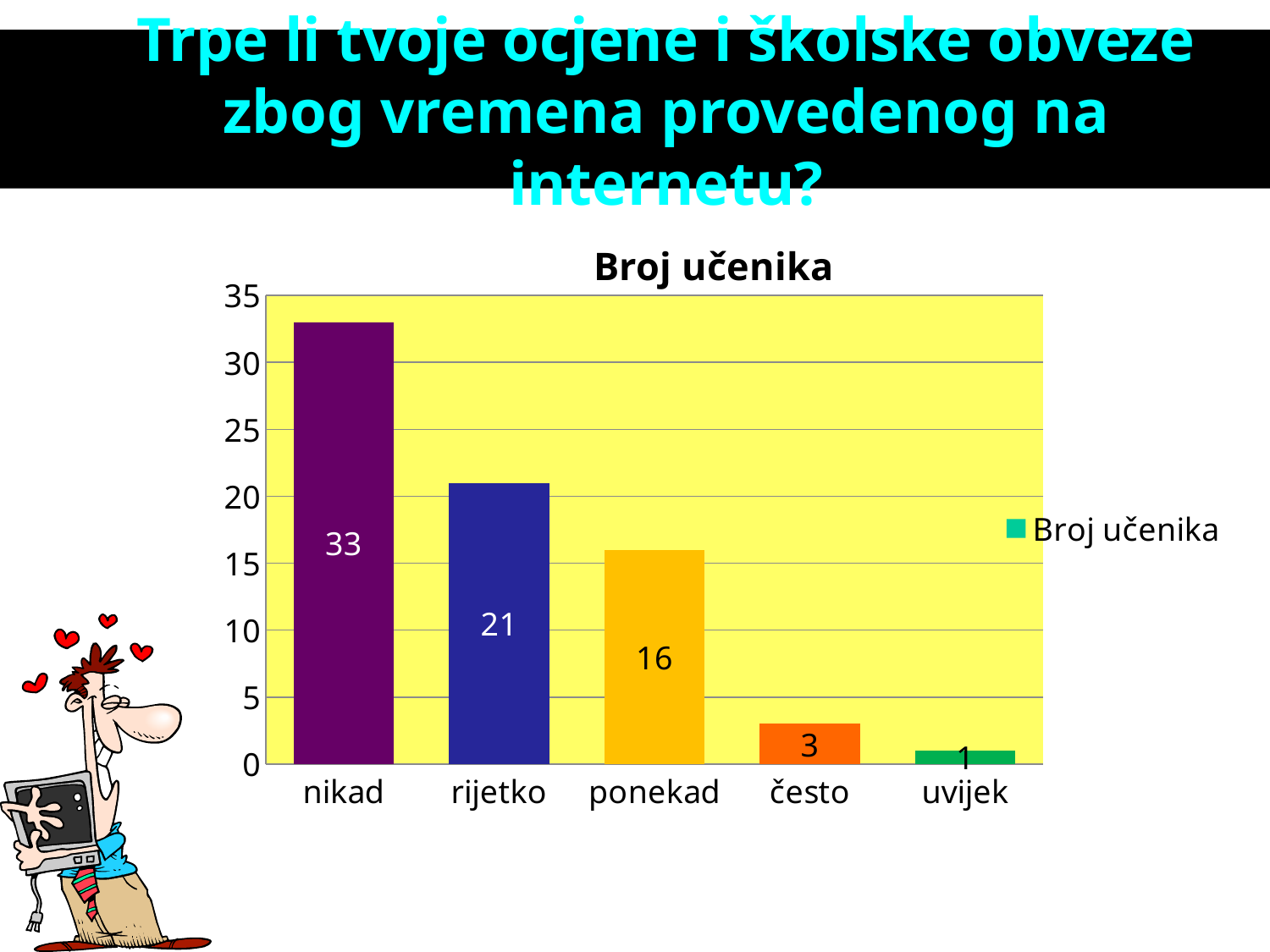
What is the value for "ponekad"? 16 Is the value for "rijetko" greater or less than 20? greater What is the value for "nikad"? 33 Which category has the highest value? nikad Which is larger, the value for "ponekad" or the value for "često"? ponekad What is the value for "rijetko"? 21 What kind of chart is shown on the slide? bar chart What is the difference between the values for "nikad" and "rijetko"? 12 What is the title of the chart? Broj učenika What is the value for "često"? 3 How many categories are shown on the x axis? 5 Which category has the lowest value? uvijek